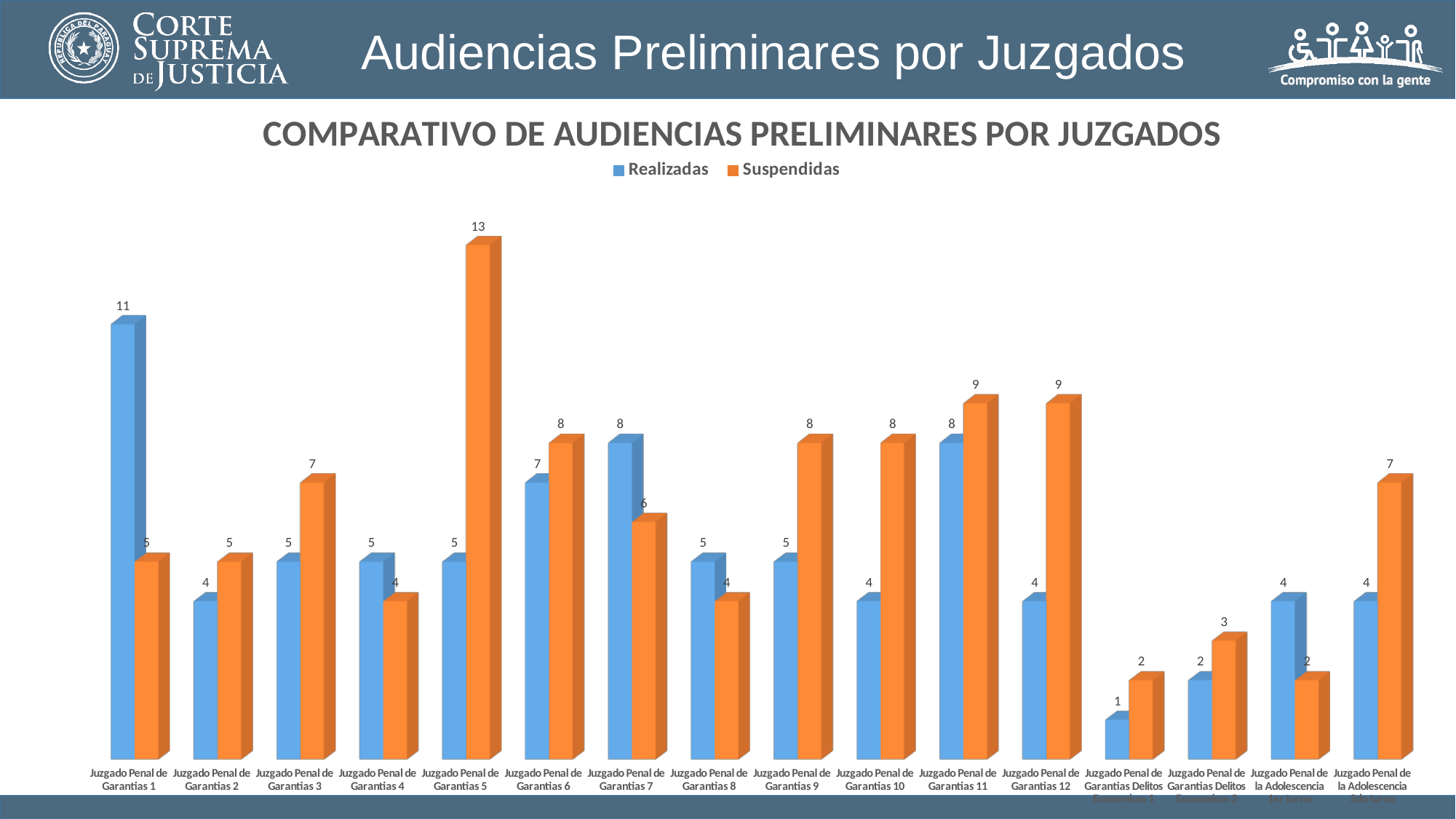
Which juzgado has the highest Realizadas value? Juzgado Penal de Garantias 1 Which juzgado has the highest Suspendidas value? Juzgado Penal de Garantias 5 What is the Realizadas value for Juzgado Penal de Garantias 1? 11 For Juzgado Penal de Garantias 7, which is larger: Realizadas or Suspendidas? Realizadas What is the Suspendidas value for Juzgado Penal de Garantias 5? 13 How many juzgados (categories) are shown on the x axis? 16 What colour represents the Suspendidas series in the legend? Orange For Juzgado Penal de Garantias 5, what is the difference between Suspendidas and Realizadas? 8 How many series does the legend list? 2 What kind of chart is shown on the slide? Bar chart For Juzgado Penal de Garantias 1, how much larger is Realizadas than Suspendidas? 6 What is the Suspendidas value for Juzgado Penal de Garantias 12? 9